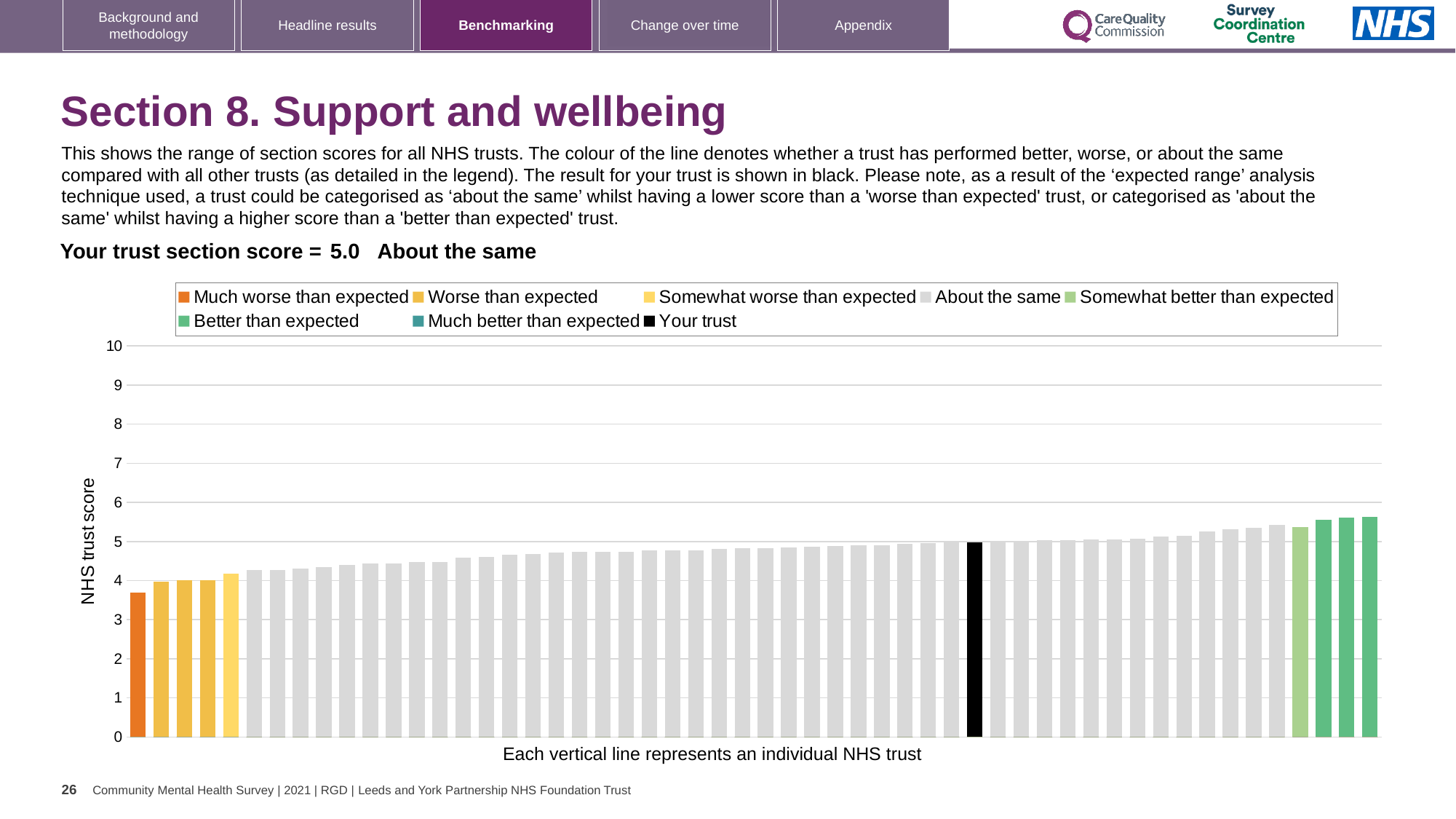
What colour is the bar representing your trust? Black How many entries does the chart legend list? 8 Do the trust scores rise or fall from left to right along the x axis? Rise Which is larger, your trust's score or the score of the lowest-scoring trust? Your trust Is the score of the highest-scoring trust (the rightmost bar) greater or less than 5? greater Is the score of the lowest-scoring trust (the leftmost bar) greater or less than 4? less Is the score of the highest-scoring trust (the rightmost bar) greater or less than 6? less How is your trust categorised for Section 8, Support and wellbeing? About the same What kind of chart is shown on the slide? Bar chart What is the label on the y axis of the chart? NHS trust score Which is larger, your trust's score or the score of the highest-scoring trust? The highest-scoring trust What is your trust's section score for Section 8, Support and wellbeing? 5.0